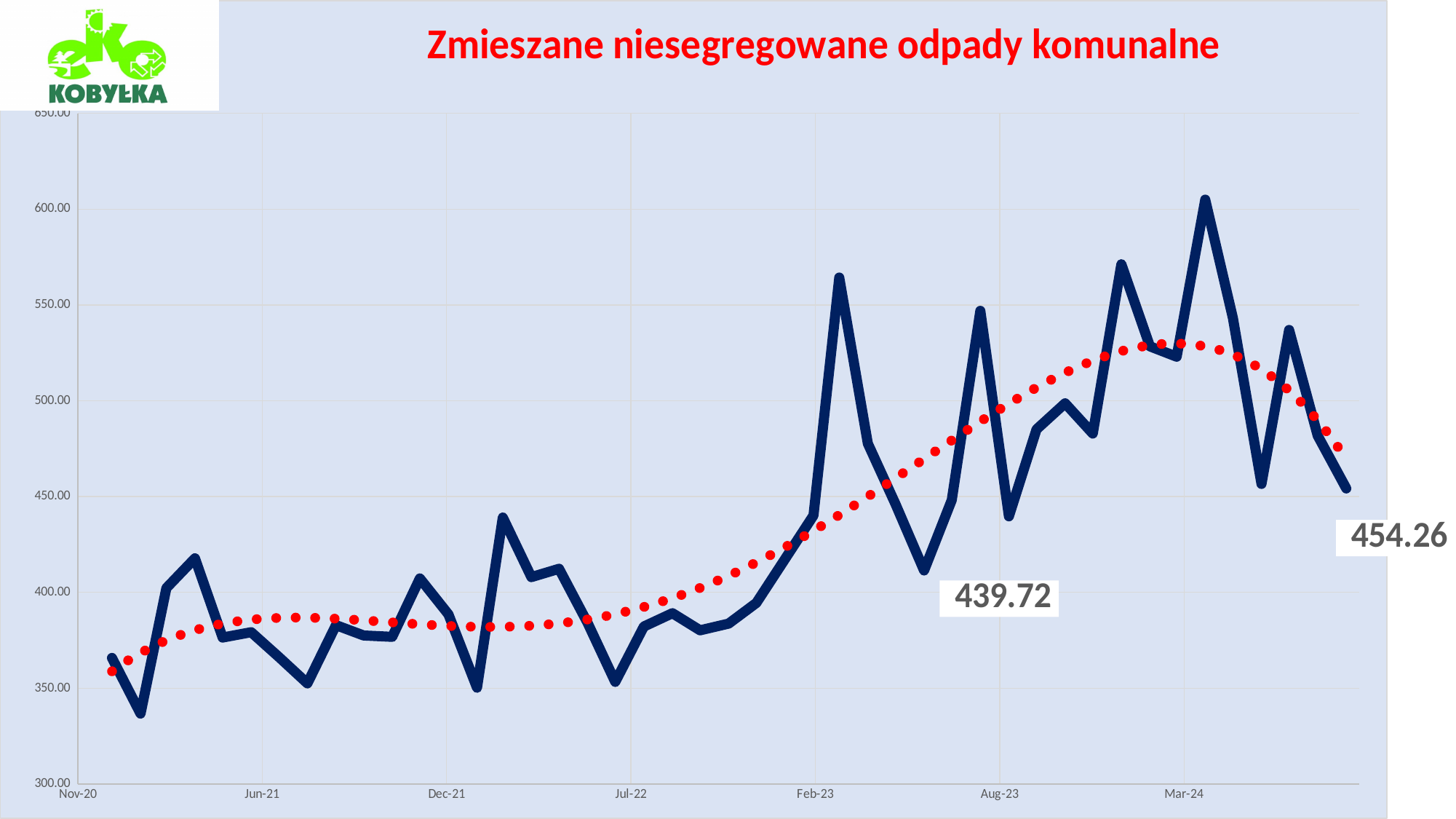
Overall, do the values rise or fall from Nov-20 to Mar-24? rise Which of the two labelled values, 454.26 or 439.72, is larger? 454.26 What value is printed as the data label at the final point of the series? 454.26 What colour is the dotted trend line on the chart? red What is the other data label printed on the chart, besides 454.26? 439.72 What is the difference between the two labelled values 454.26 and 439.72? 14.54 What is the title of the chart? Zmieszane niesegregowane odpady komunalne What kind of chart is shown on the slide? line chart How many date labels are shown on the x axis? 7 Is the labelled final value of 454.26 greater or less than 500? less Is the lowest point of the dark blue line greater or less than 350? less Is the highest peak of the dark blue line greater or less than 550? greater